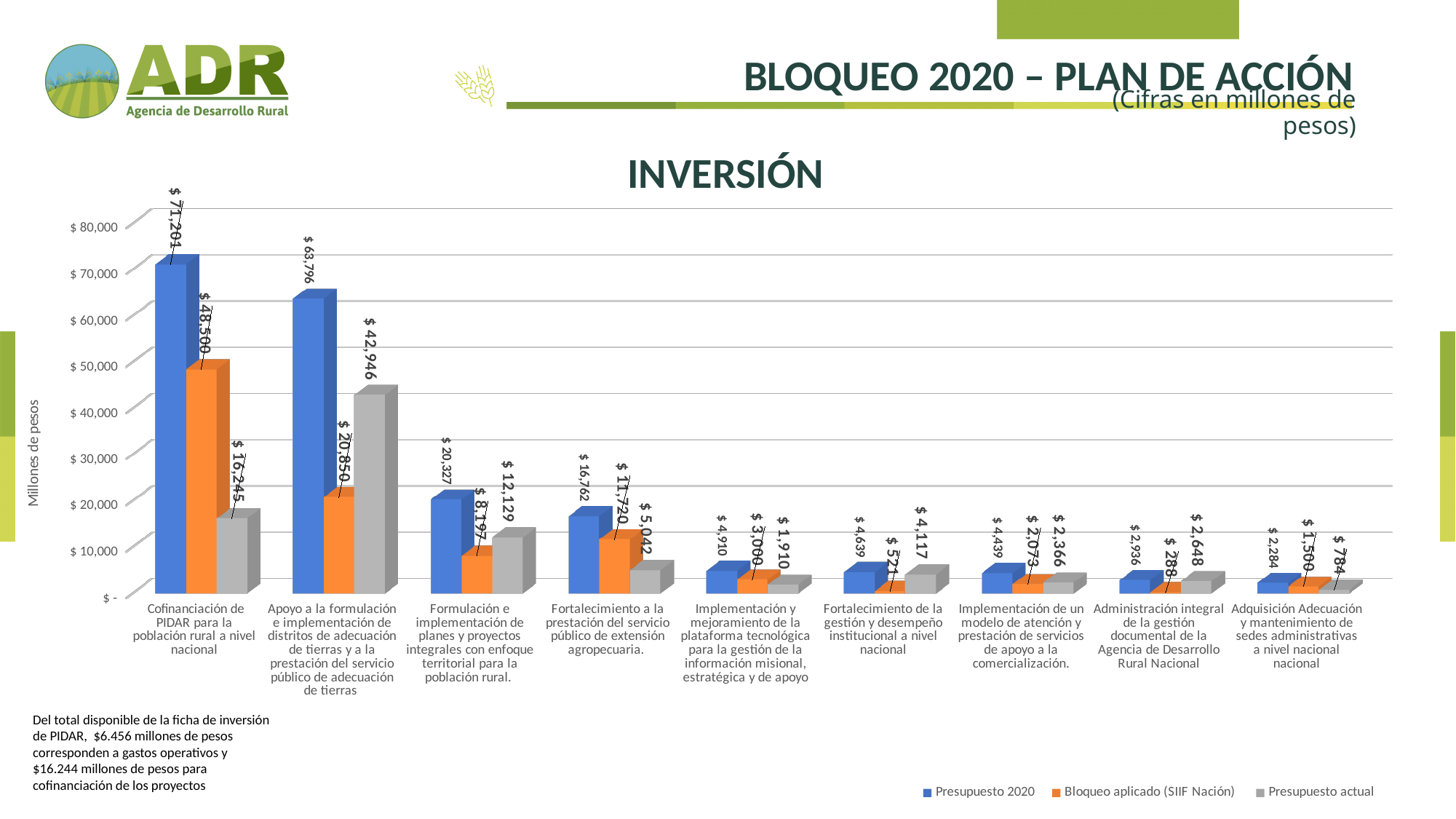
Which category has the highest Presupuesto 2020 value? Cofinanciación de PIDAR para la población rural a nivel nacional How many series does the legend list? 3 What is the Presupuesto 2020 value for 'Cofinanciación de PIDAR para la población rural a nivel nacional'? $ 71,201 What type of chart is shown on the slide? Bar chart What is the Presupuesto actual value for 'Fortalecimiento a la prestación del servicio público de extensión agropecuaria'? $ 5,042 How many categories are shown on the x axis of the INVERSIÓN chart? 9 What is the Bloqueo aplicado (SIIF Nación) value for 'Apoyo a la formulación e implementación de distritos de adecuación de tierras y a la prestación del servicio público de adecuación de tierras'? $ 20,850 Is the Presupuesto 2020 value for 'Formulación e implementación de planes y proyectos integrales con enfoque territorial para la población rural' greater or less than 30,000? less What is the title of the chart? INVERSIÓN What is the difference between the Presupuesto 2020 and Bloqueo aplicado (SIIF Nación) values for 'Apoyo a la formulación e implementación de distritos de adecuación de tierras y a la prestación del servicio público de adecuación de tierras'? $ 42,946 Which is larger for 'Fortalecimiento de la gestión y desempeño institucional a nivel nacional': the Bloqueo aplicado (SIIF Nación) value or the Presupuesto actual value? Presupuesto actual Which category has the lowest Bloqueo aplicado (SIIF Nación) value? Administración integral de la gestión documental de la Agencia de Desarrollo Rural Nacional